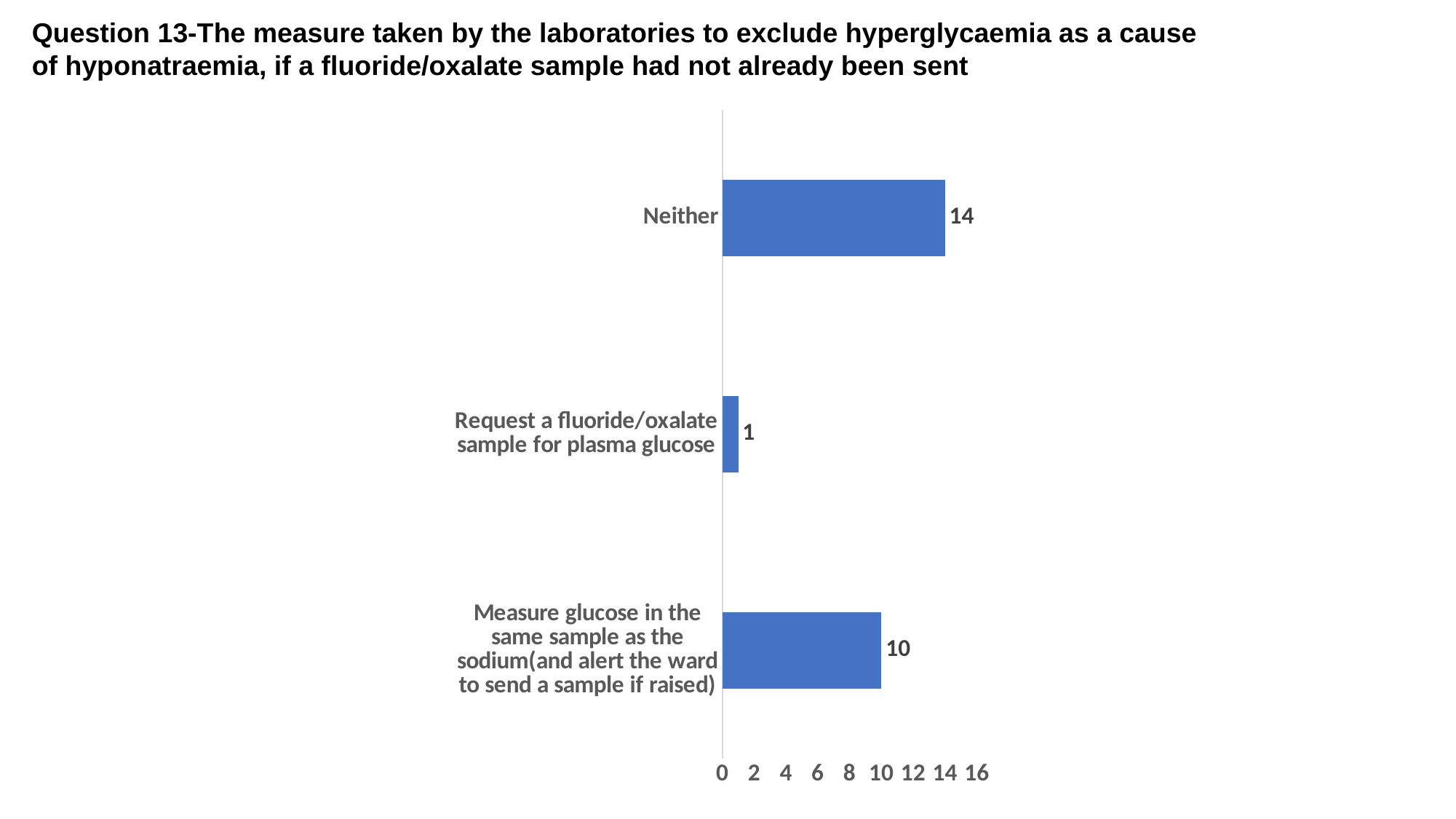
What is the value for "Request a fluoride/oxalate sample for plasma glucose"? 1 What is the value for "Measure glucose in the same sample as the sodium (and alert the ward to send a sample if raised)"? 10 What is the value for "Neither"? 14 Which category has the lowest value? Request a fluoride/oxalate sample for plasma glucose What is the highest tick value shown on the horizontal axis? 16 How many categories are shown in the chart? 3 Is the value for "Neither" greater or less than 12? greater What is the difference between the values for "Neither" and "Measure glucose in the same sample as the sodium"? 4 What kind of chart is shown on the slide? Bar chart What is the difference between the values for "Measure glucose in the same sample as the sodium" and "Request a fluoride/oxalate sample for plasma glucose"? 9 Which category has the highest value? Neither Which is larger, the value for "Neither" or the value for "Measure glucose in the same sample as the sodium"? Neither